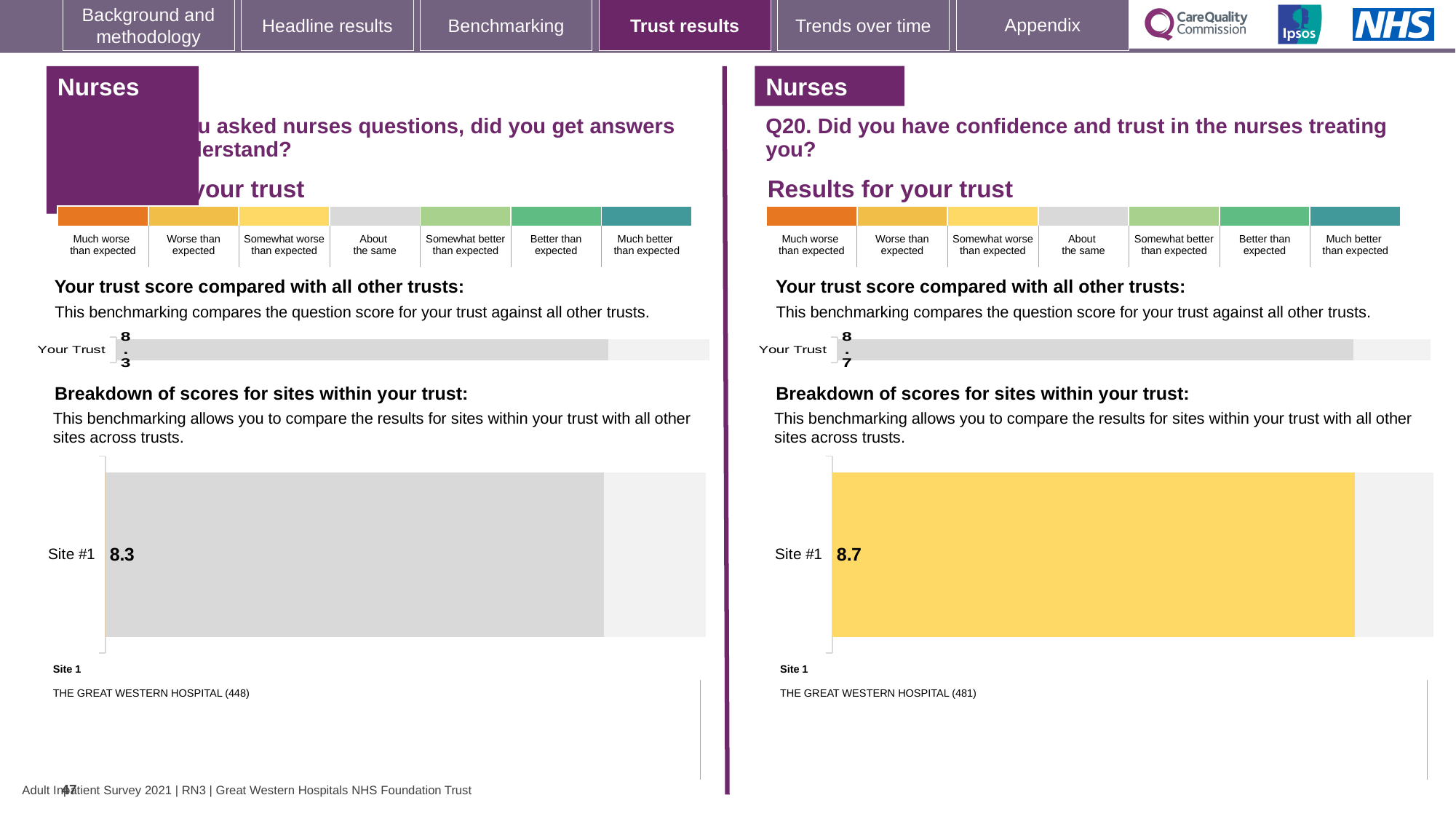
On the left-hand 'Your trust score compared with all other trusts' chart, what is the score shown for Your Trust? 8.3 What colour is the Site #1 bar on the right-hand (Q20) 'Breakdown of scores for sites within your trust' chart? Yellow On the left-hand 'Breakdown of scores for sites within your trust' chart, what is the score for Site #1? 8.3 What kind of chart is used for the 'Breakdown of scores for sites within your trust' on the right-hand (Q20) side? Bar chart How many sites are plotted on the right-hand (Q20) 'Breakdown of scores for sites within your trust' chart? 1 Which is larger: the Site #1 score on the left-hand breakdown chart or the Site #1 score on the right-hand (Q20) breakdown chart? The right-hand (Q20) chart On the right-hand (Q20) 'Your trust score compared with all other trusts' chart, what is the score shown for Your Trust? 8.7 On the right-hand (Q20) 'Breakdown of scores for sites within your trust' chart, what is the score for Site #1? 8.7 What is the difference between the Site #1 score on the right-hand (Q20) breakdown chart and the Site #1 score on the left-hand breakdown chart? 0.4 What colour is the Site #1 bar on the left-hand 'Breakdown of scores for sites within your trust' chart? Grey Is the Your Trust score on the right-hand (Q20) 'Your trust score compared with all other trusts' chart greater or less than 8.5? greater How many sites are plotted on the left-hand 'Breakdown of scores for sites within your trust' chart? 1